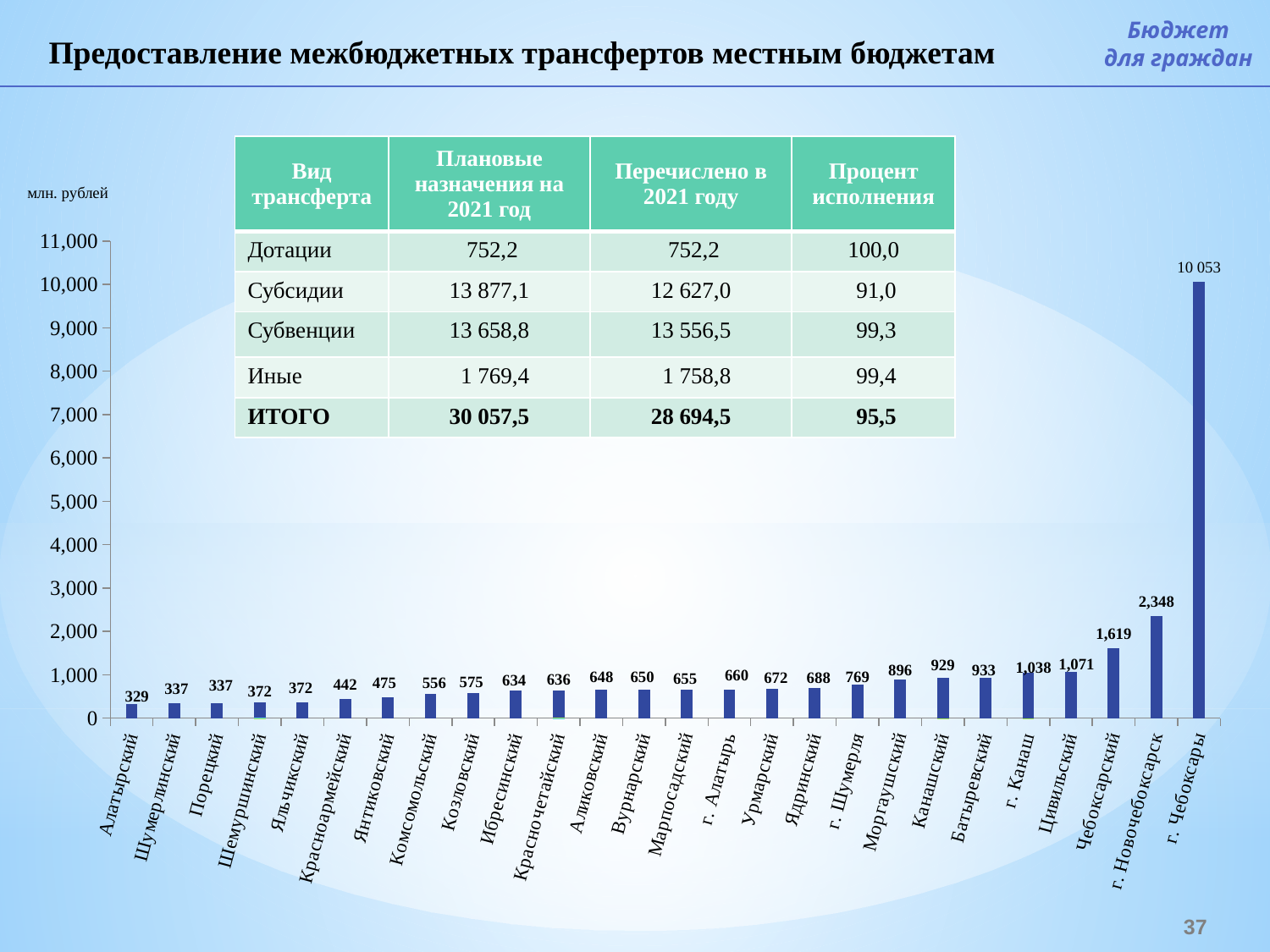
Which is larger, the value for Канашский or the value for Батыревский? Батыревский What unit is indicated for the chart's values? млн. рублей What is the value for Моргаушский? 896 What kind of chart is shown on the slide? bar chart Is the value for Цивильский greater or less than 1,000? greater What is the difference between the values for г. Новочебоксарск and Чебоксарский? 729 Which category has the lowest value? Алатырский What is the value for г. Чебоксары? 10 053 Do the values rise or fall from left to right along the x axis? rise How many categories are shown on the x axis of the chart? 26 What is the value for г. Новочебоксарск? 2,348 Which category has the highest value? г. Чебоксары